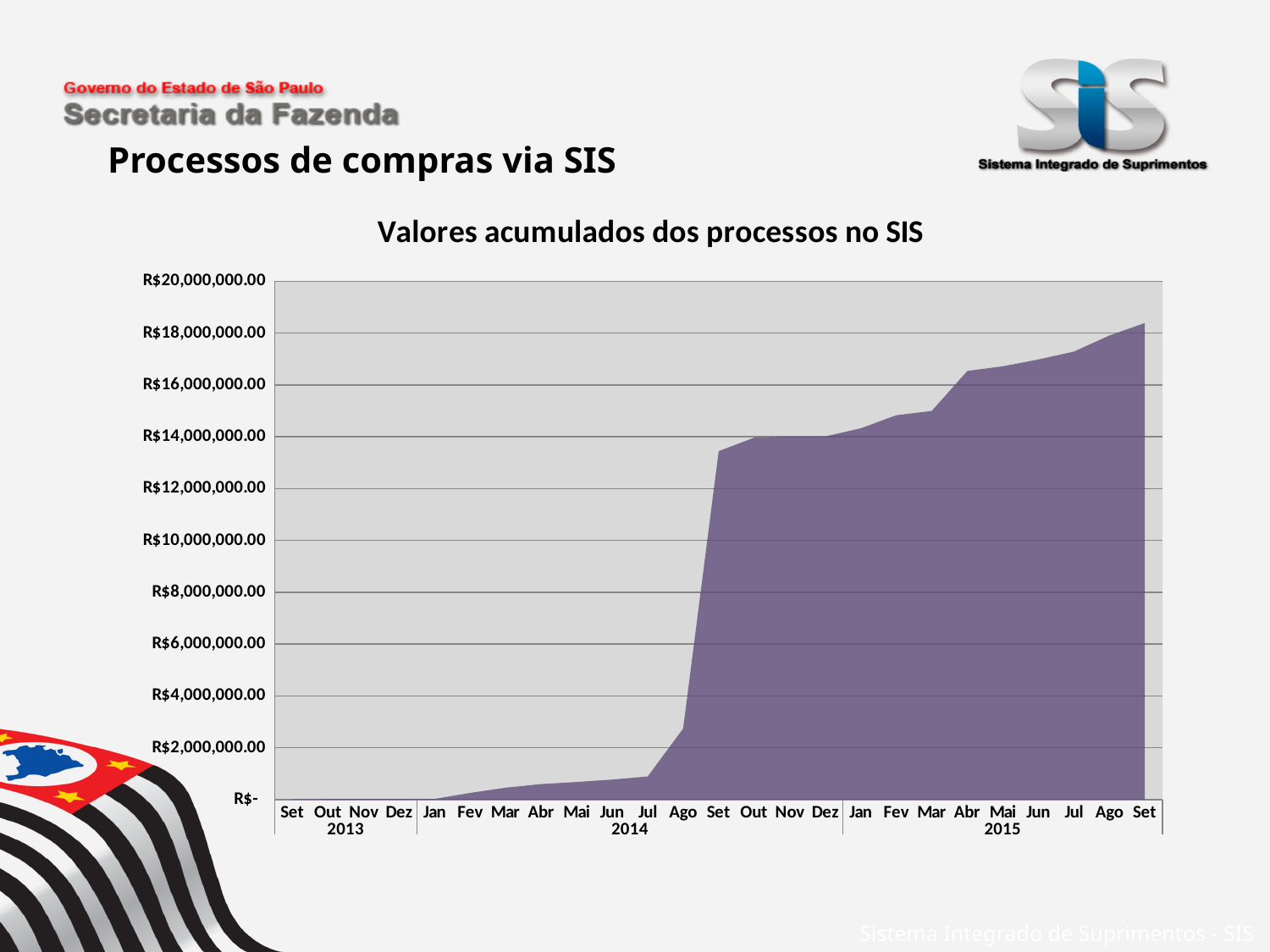
What kind of chart is shown on the slide? area chart How many months are plotted along the x axis of the chart? 25 What is the highest value shown on the y axis of the chart? R$20,000,000.00 Is the value for Set 2015 greater or less than R$18,000,000.00? greater Do the accumulated values rise or fall from Set 2013 to Set 2015? rise Is the value for Abr 2015 greater or less than R$16,000,000.00? greater Is the value for Set 2014 greater or less than R$14,000,000.00? less What is the title of the chart? Valores acumulados dos processos no SIS Which month has the highest accumulated value in the chart? Set 2015 Which is larger, the value for Ago 2014 or the value for Set 2014? Set 2014